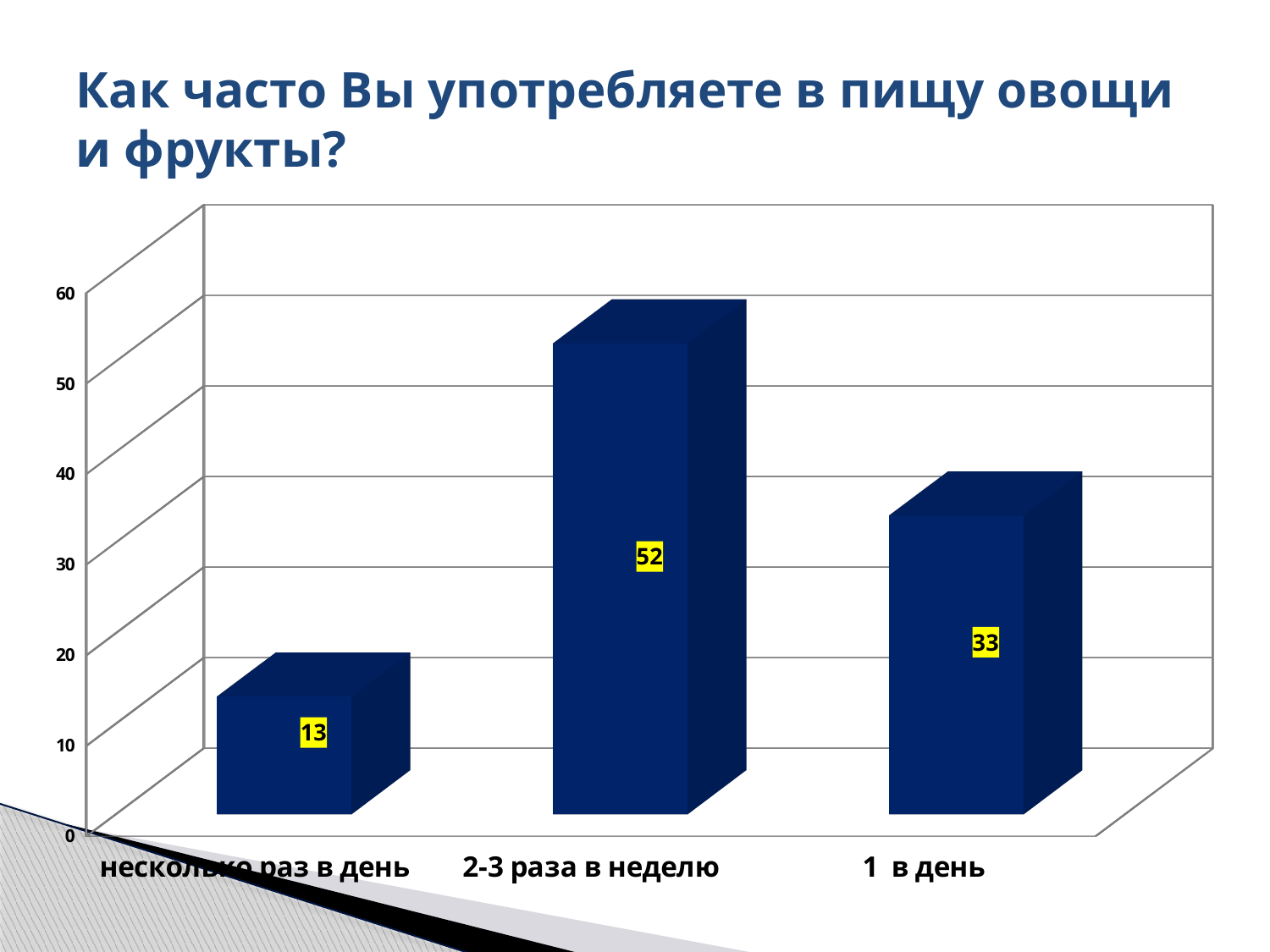
Which category has the highest value? 2-3 раза в неделю What is the value for "несколько раз в день"? 13 What kind of chart is shown on the slide? bar chart What is the title of the slide? Как часто Вы употребляете в пищу овощи и фрукты? Is the value for "2-3 раза в неделю" greater or less than 40? greater What is the value for "1 в день"? 33 How many categories are shown in the chart? 3 Which category has the lowest value? несколько раз в день What is the value for "2-3 раза в неделю"? 52 Which is larger: the value for "1 в день" or the value for "несколько раз в день"? 1 в день What is the difference between the values for "1 в день" and "несколько раз в день"? 20 What is the difference between the values for "2-3 раза в неделю" and "1 в день"? 19